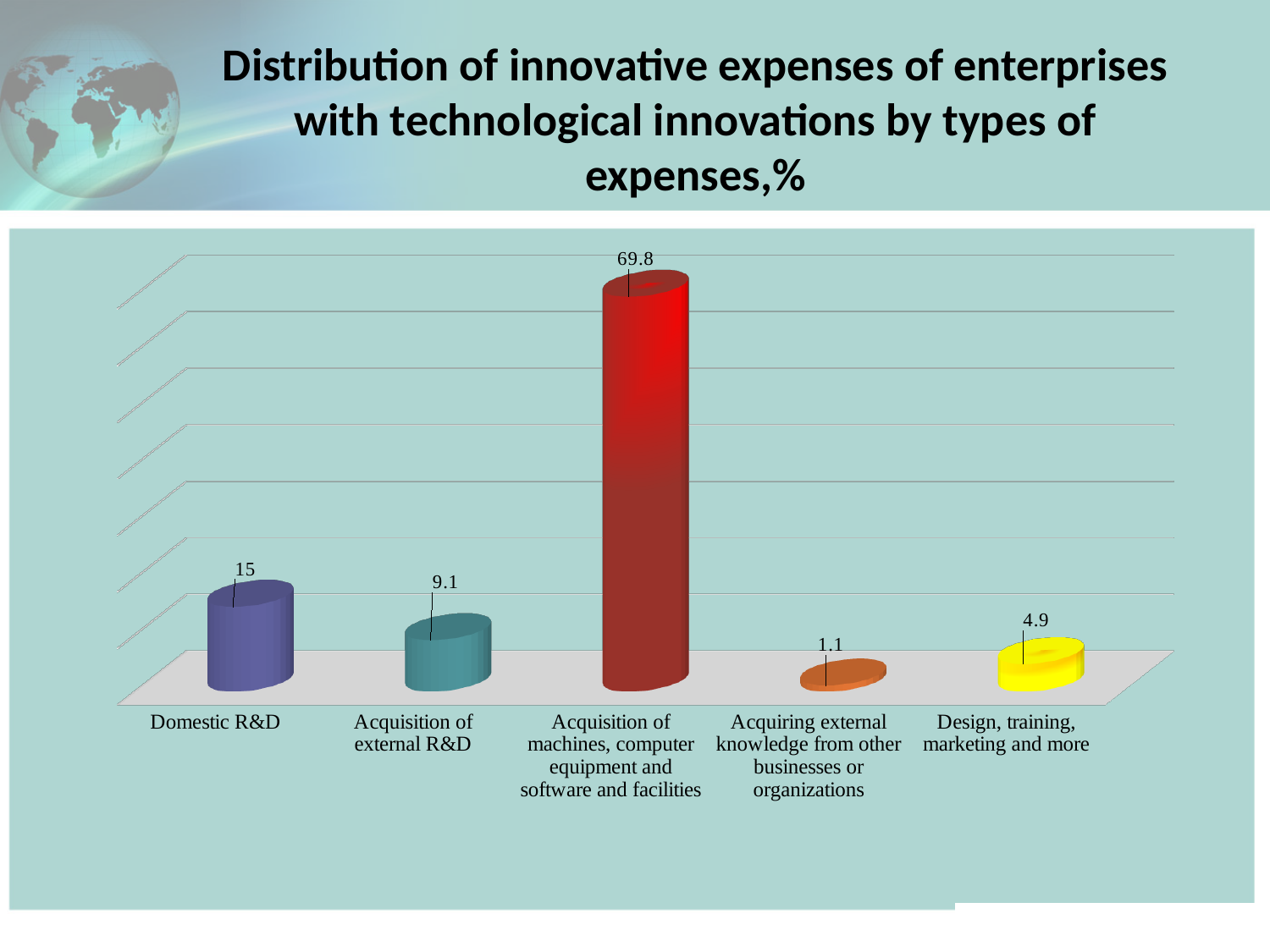
Which type of expense has the highest value? Acquisition of machines, computer equipment and software and facilities What is the value for Design, training, marketing and more? 4.9 What is the difference between the values for Domestic R&D and Acquisition of external R&D? 5.9 Which type of expense has the lowest value? Acquiring external knowledge from other businesses or organizations What is the value for Acquiring external knowledge from other businesses or organizations? 1.1 What is the title of the chart? Distribution of innovative expenses of enterprises with technological innovations by types of expenses,% How many types of expenses are shown in the chart? 5 What is the value for Acquisition of external R&D? 9.1 What kind of chart is shown on the slide? Bar chart What is the value for Acquisition of machines, computer equipment and software and facilities? 69.8 Which is larger, the value for Design, training, marketing and more or the value for Acquiring external knowledge from other businesses or organizations? Design, training, marketing and more What is the value for Domestic R&D? 15